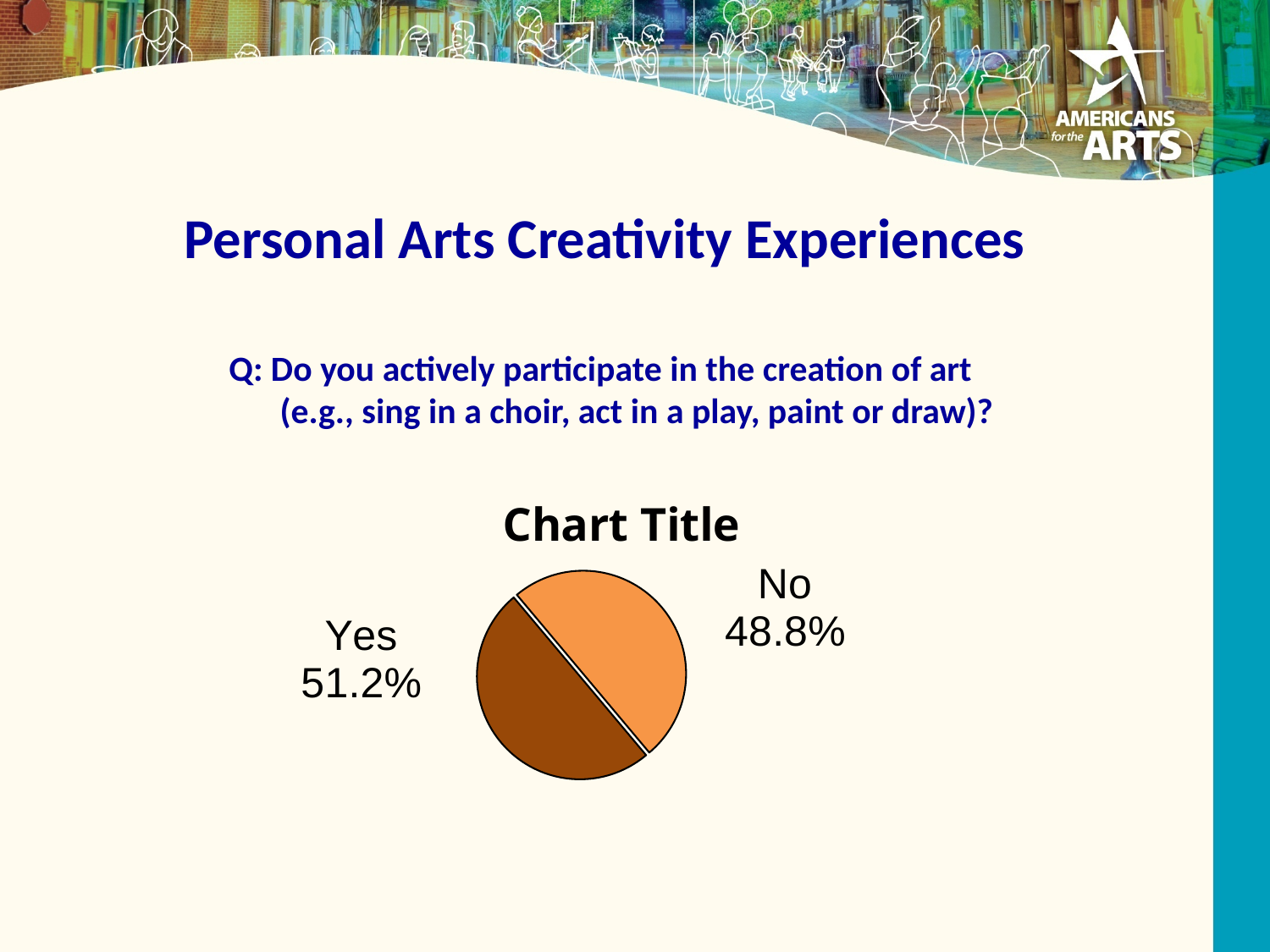
What is the title printed above the pie chart? Chart Title What is the difference in percentage points between the Yes and No slices? 2.4 What percentage of respondents answered No? 48.8% Which slice of the pie is the largest? Yes How many slices does the pie chart have? 2 What percentage of respondents answered Yes? 51.2% What colour is the Yes slice of the pie? dark brown Which is larger, the Yes slice or the No slice? Yes What kind of chart is shown on the slide? pie chart Which slice of the pie is the smallest? No